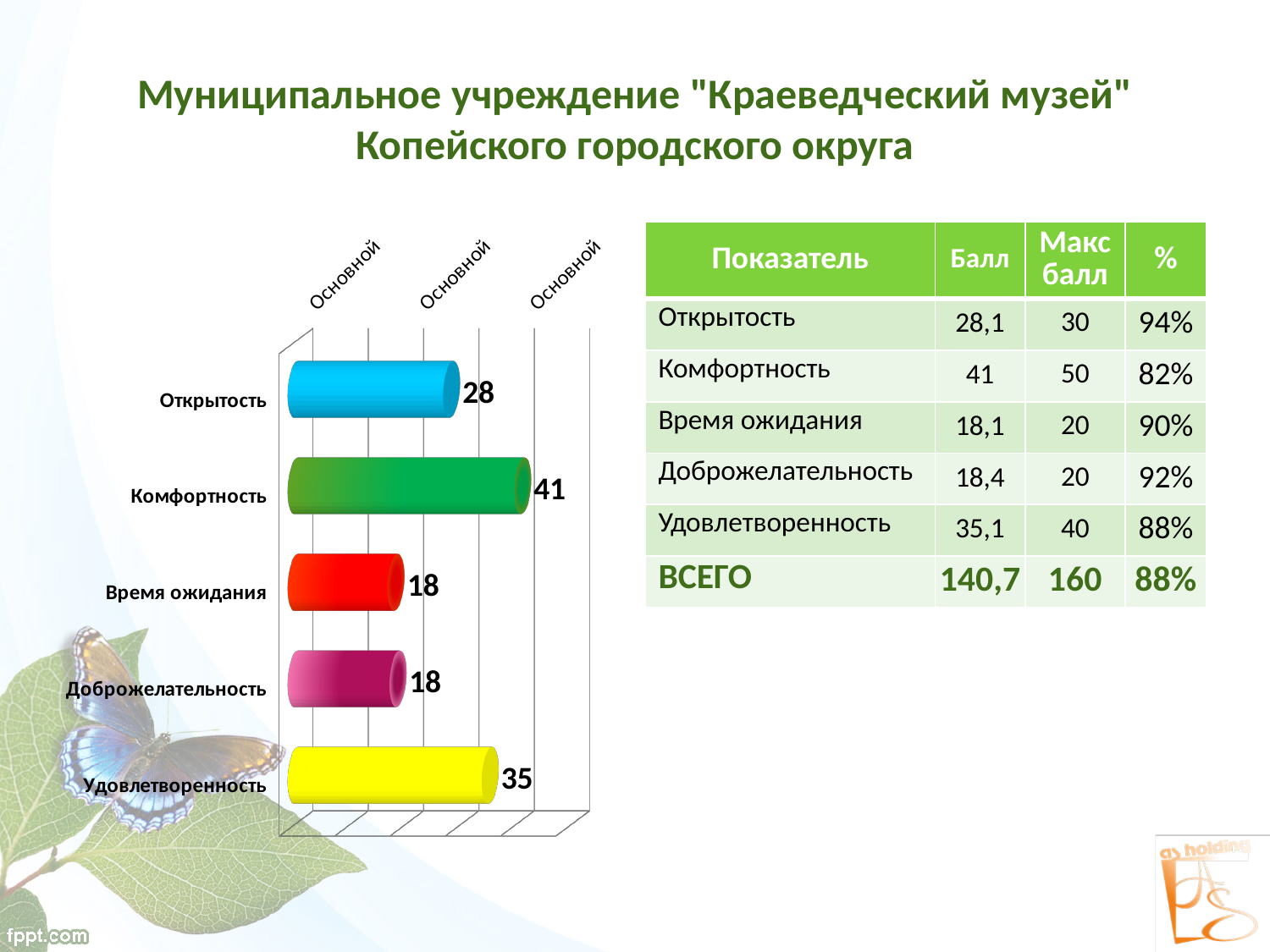
What is the lowest value shown on the chart? 18 What kind of chart is shown on the slide? bar chart What colour is the bar for Удовлетворенность? yellow What is the difference between the values for Удовлетворенность and Доброжелательность? 17 Which is larger, the value for Удовлетворенность or the value for Открытость? Удовлетворенность What is the difference between the values for Комфортность and Открытость? 13 What value is shown for Удовлетворенность on the chart? 35 How many categories are plotted on the chart? 5 What value is shown for Комфортность on the chart? 41 What value is shown for Время ожидания on the chart? 18 Which category has the highest value on the chart? Комфортность What value is shown for Открытость on the chart? 28